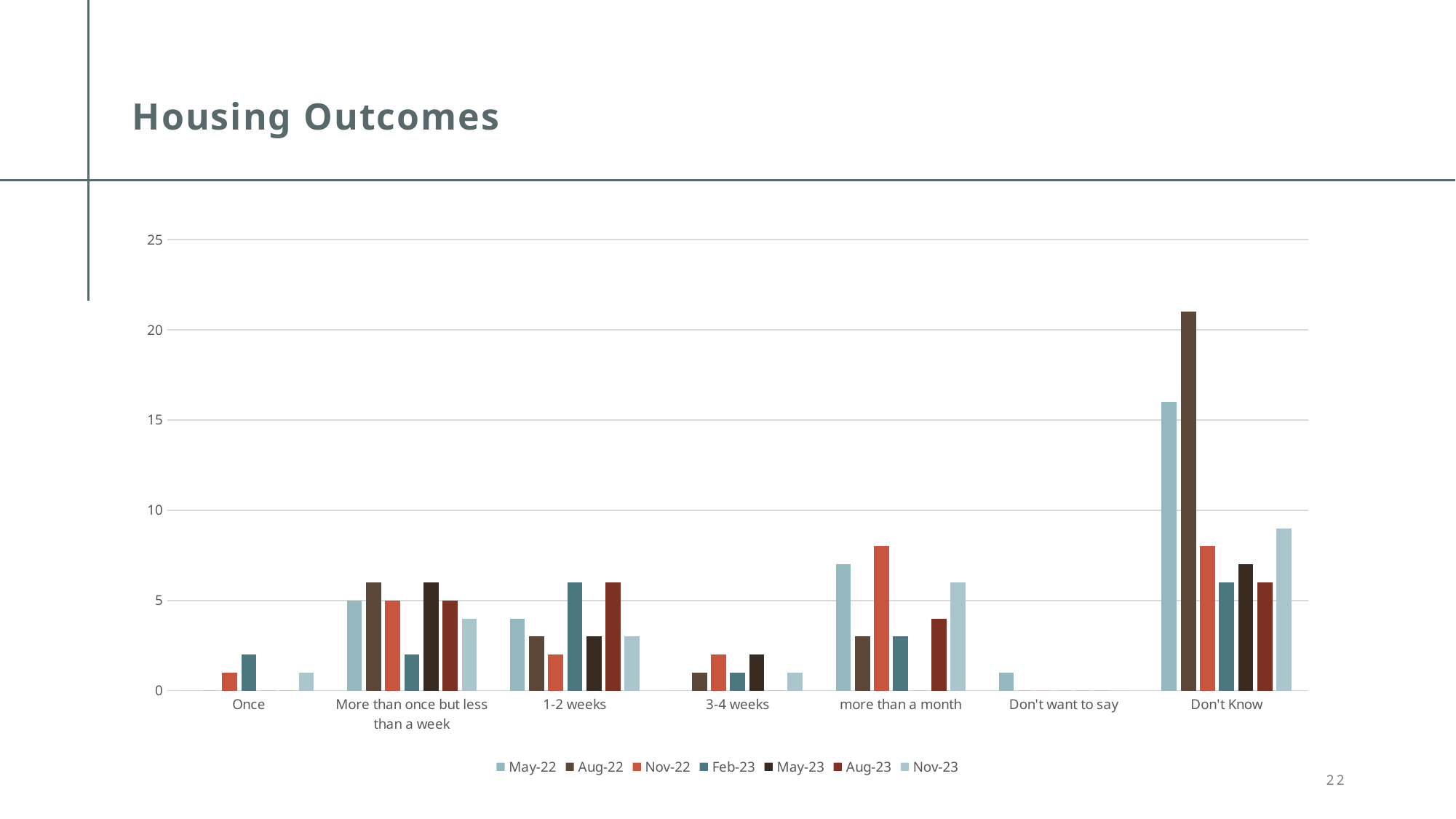
For Don't Know, which is larger: the Aug-22 bar or the May-22 bar? Aug-22 What is the title of the slide containing the chart? Housing Outcomes Which category contains the tallest bar in the chart? Don't Know Is the May-22 value for Don't Know greater or less than 10? greater How many categories are shown on the x axis? 7 What is the first series listed in the legend? May-22 For more than a month, which is larger: the Nov-22 bar or the Aug-22 bar? Nov-22 What is the May-22 value for More than once but less than a week? 5 Is the Nov-22 value for more than a month greater or less than 10? less What kind of chart is shown on the slide? bar chart How many series does the legend list? 7 Is the Aug-22 value for Don't Know greater or less than 20? greater